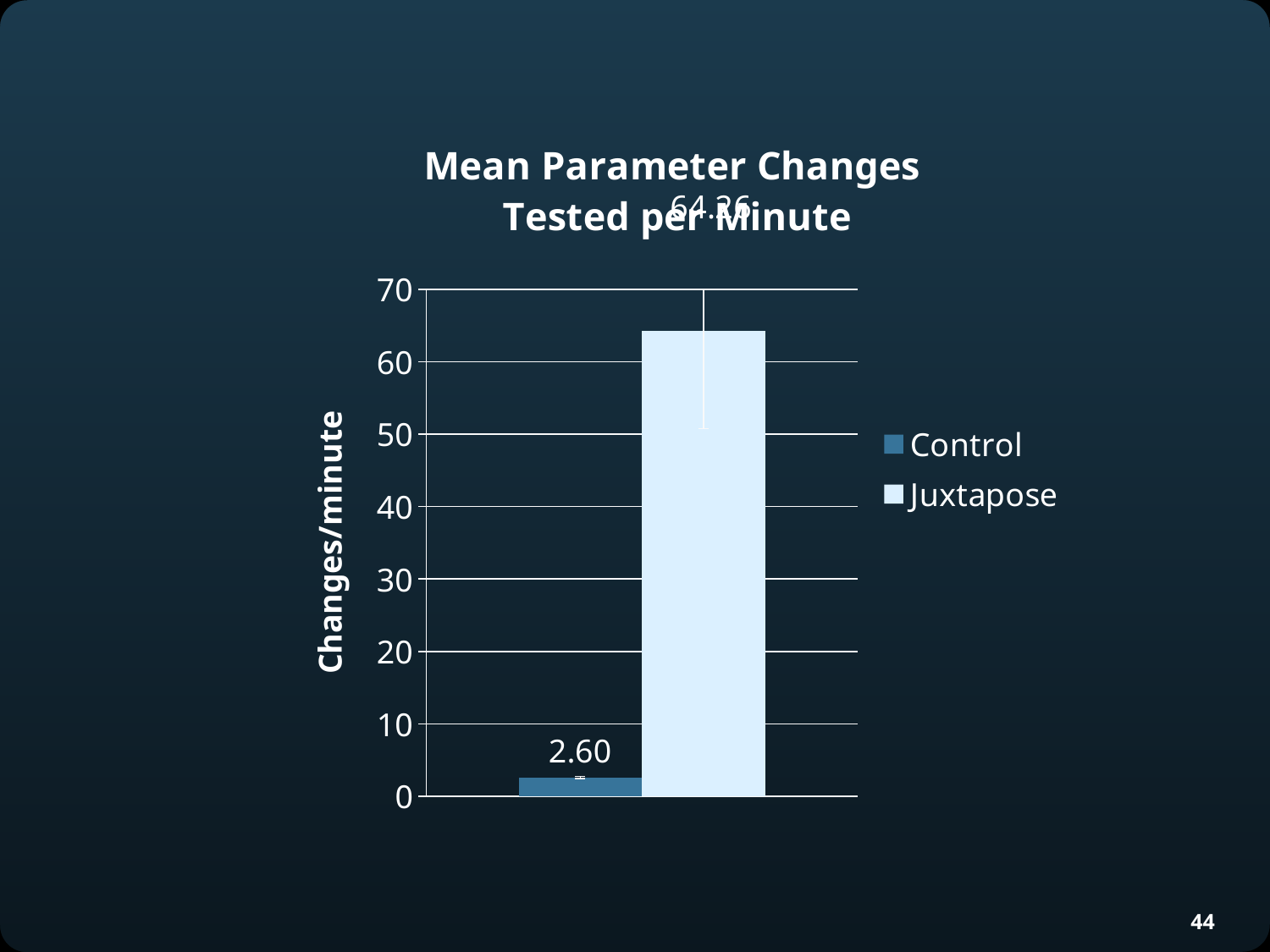
Is the value for Juxtapose greater or less than 60? greater Which series has the highest value? Juxtapose Is the value for Control greater or less than 10? less Which series has the lowest value? Control What is the label of the vertical axis? Changes/minute What is the value for Juxtapose? 64.26 What kind of chart is shown on the slide? bar chart What is the value for Control? 2.60 Which series has the higher value, Control or Juxtapose? Juxtapose How many series does the legend list? 2 What is the difference between the Juxtapose and Control values? 61.66 What is the title of the chart? Mean Parameter Changes Tested per Minute